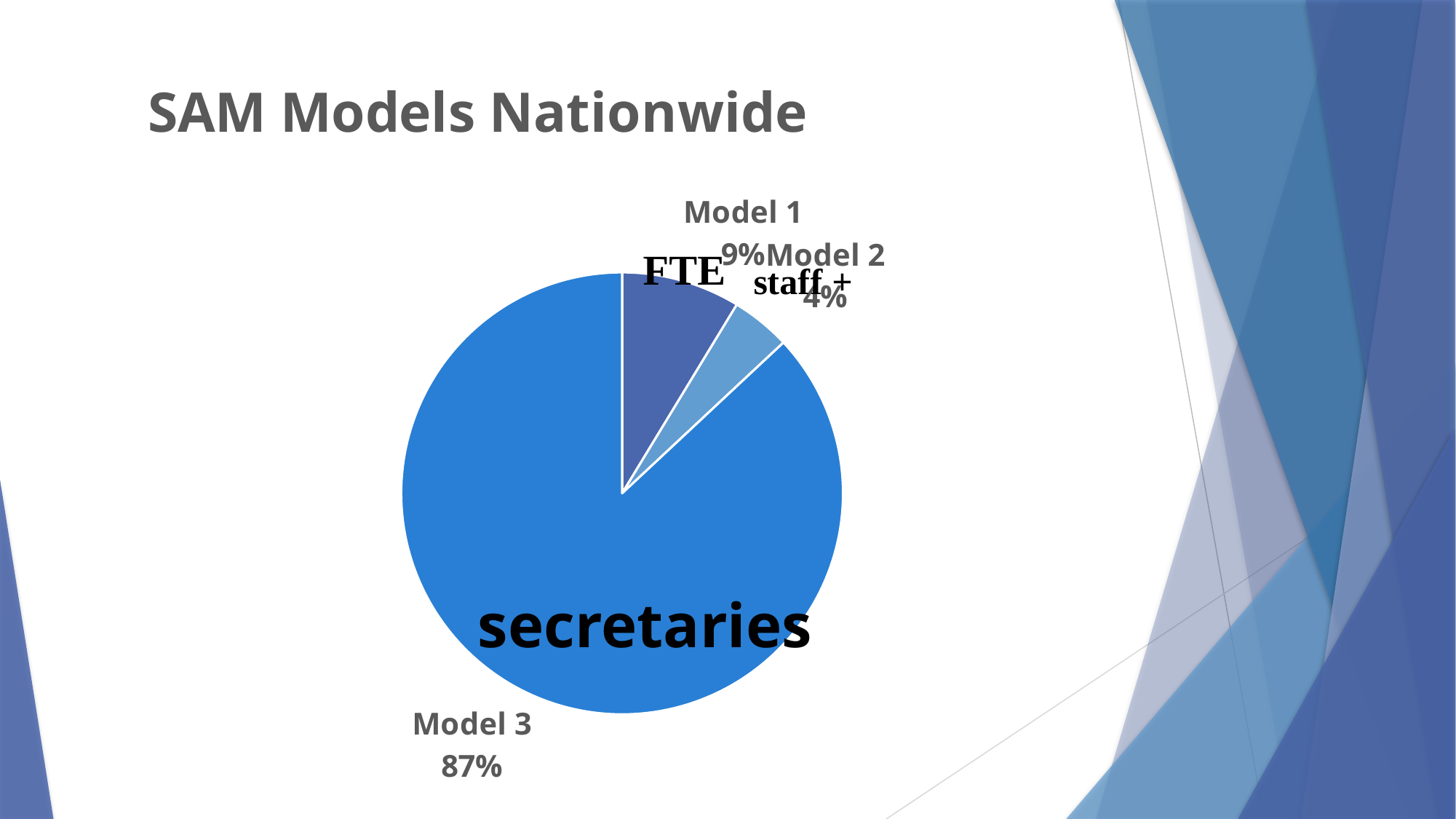
What is the title of the slide containing the pie chart? SAM Models Nationwide What percentage of the pie does Model 3 represent? 87% What is the difference in percentage points between Model 3 and Model 1? 78 Which has a larger share of the pie, Model 1 or Model 2? Model 1 How many slices does the pie chart have? 3 What percentage of the pie does Model 1 represent? 9% What percentage of the pie does Model 2 represent? 4% What word is written over the largest slice of the pie chart? secretaries Which model has the smallest share of the pie? Model 2 What is the difference in percentage points between Model 1 and Model 2? 5 Which model has the largest share of the pie? Model 3 What kind of chart is shown on the slide? pie chart